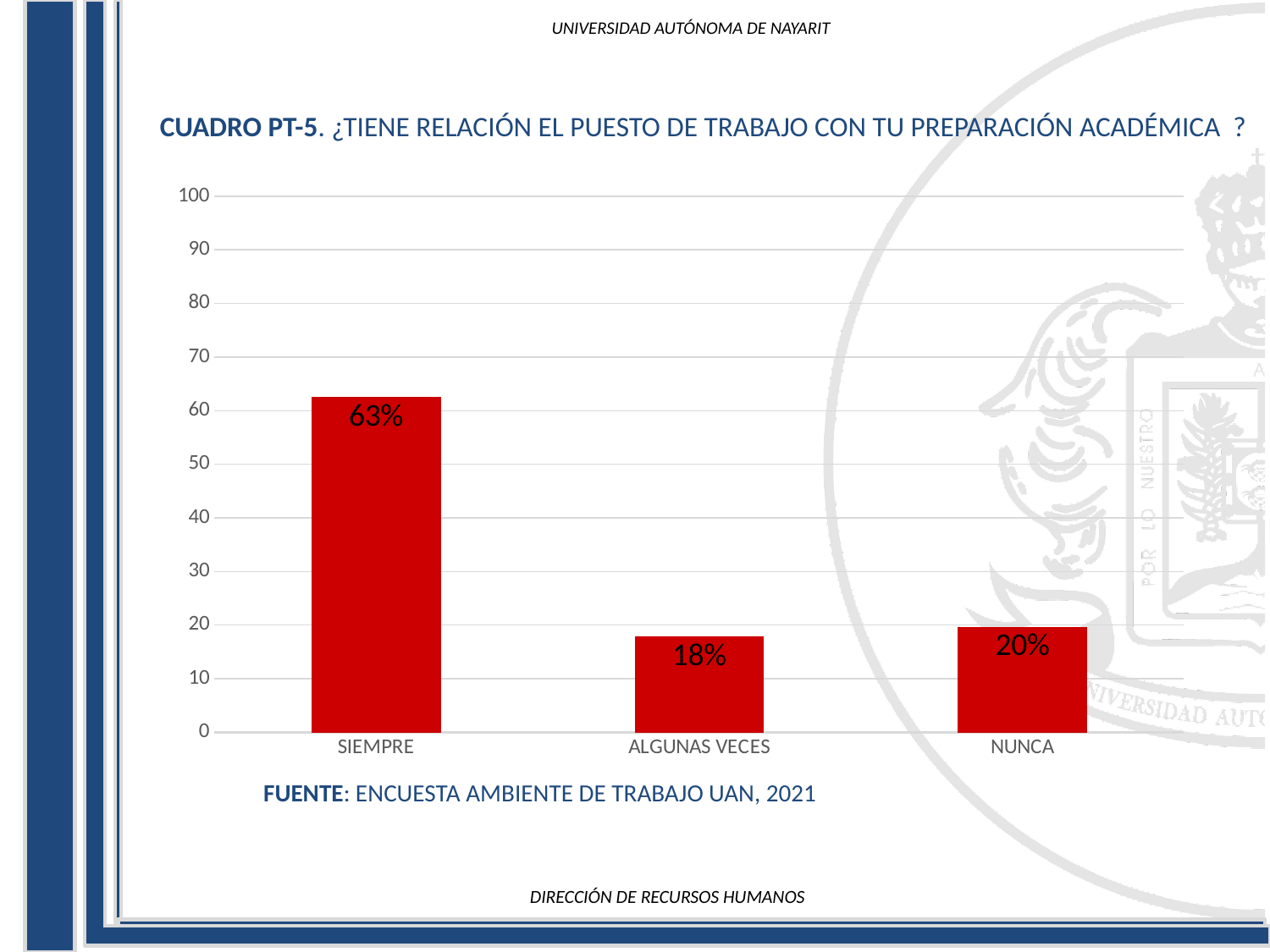
How many categories are shown on the x axis? 3 Which category has the highest value? SIEMPRE What source is cited below the chart? ENCUESTA AMBIENTE DE TRABAJO UAN, 2021 Which is larger, the value for SIEMPRE or the value for ALGUNAS VECES? SIEMPRE What is the value for SIEMPRE? 63% What is the value for NUNCA? 20% What is the difference between the values for NUNCA and ALGUNAS VECES? 2% Is the value for SIEMPRE greater or less than 50? greater What is the value for ALGUNAS VECES? 18% What kind of chart is shown on the slide? bar chart What is the difference between the values for SIEMPRE and NUNCA? 43% Which category has the lowest value? ALGUNAS VECES